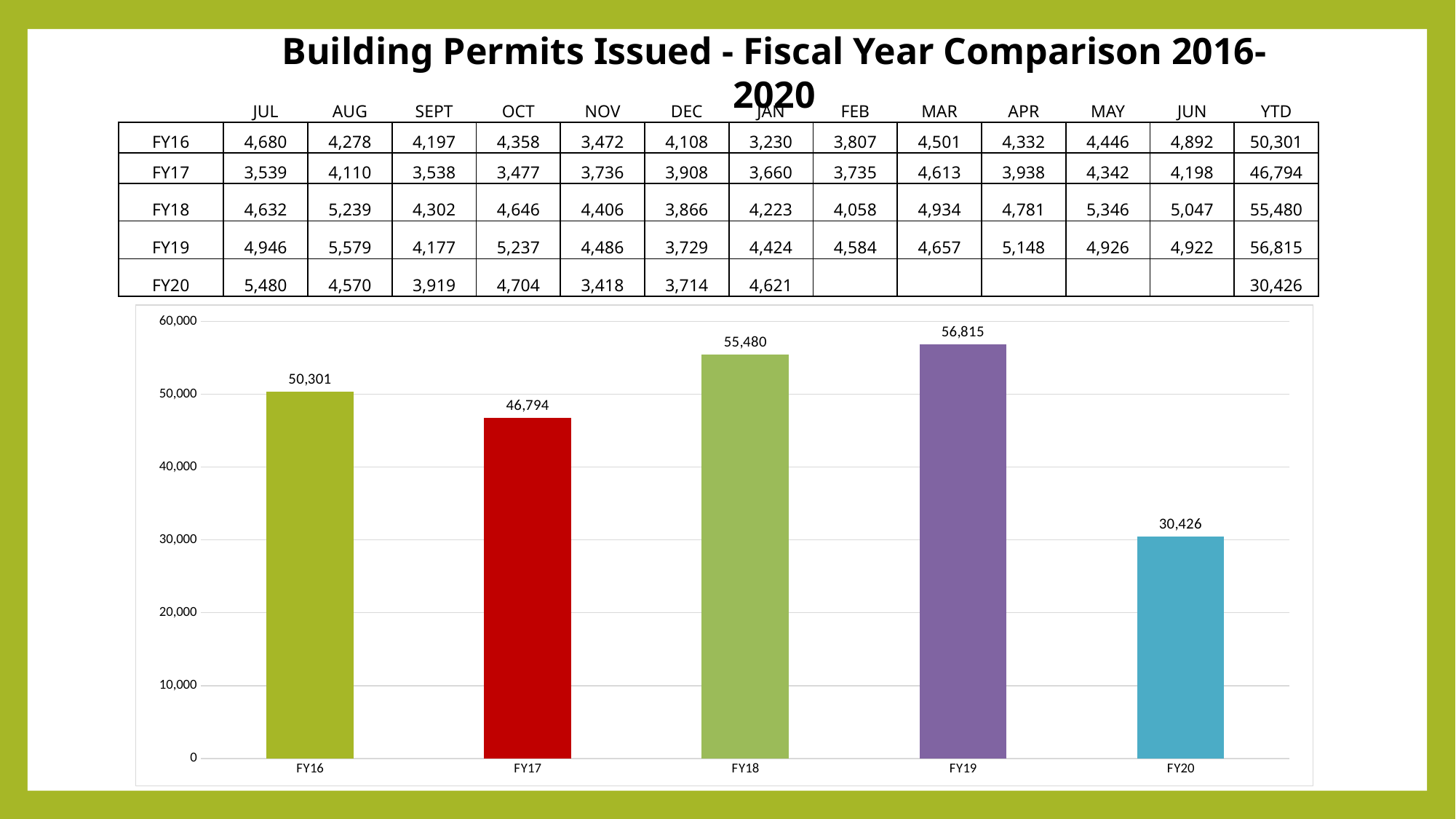
Which fiscal year has the lowest bar? FY20 Which is larger, the bar for FY16 or the bar for FY17? FY16 Which fiscal year has the highest bar? FY19 What is the difference between the FY19 and FY18 bar values? 1,335 What is the value of the bar for FY18? 55,480 How many bars are shown in the chart? 5 What kind of chart is shown on the slide? bar chart What is the title of the slide? Building Permits Issued - Fiscal Year Comparison 2016-2020 What colour is the bar for FY17? red What is the difference between the FY16 and FY17 bar values? 3,507 Is the value for FY17 greater or less than 50,000? less What is the value of the bar for FY20? 30,426